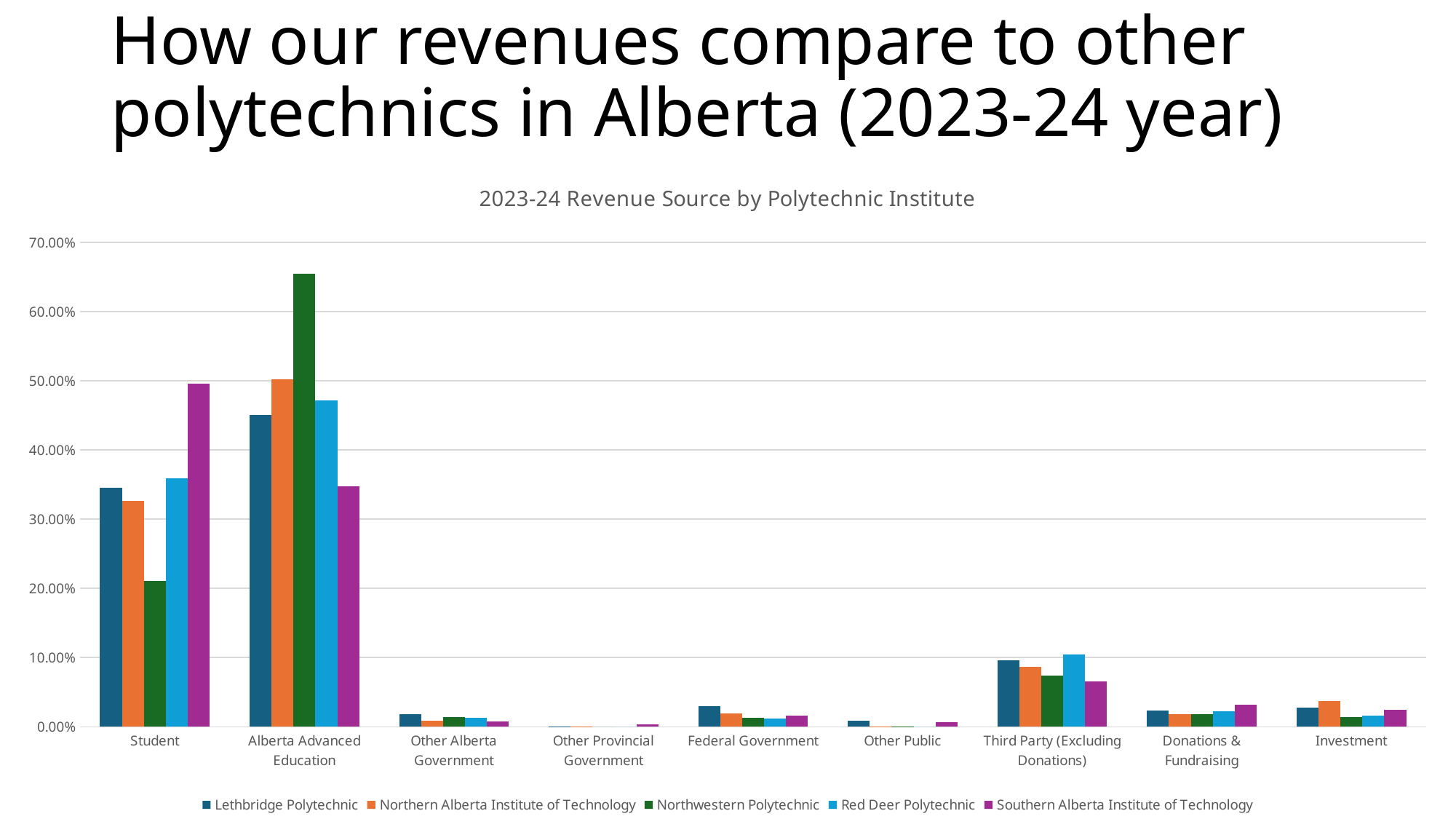
Which institution has the highest share of revenue from Alberta Advanced Education? Northwestern Polytechnic For Alberta Advanced Education, which is larger: Northern Alberta Institute of Technology or Southern Alberta Institute of Technology? Northern Alberta Institute of Technology What is the title of the chart? 2023-24 Revenue Source by Polytechnic Institute Is the Student value for Southern Alberta Institute of Technology greater or less than 40.00%? greater Is the Alberta Advanced Education value for Lethbridge Polytechnic greater or less than 50.00%? less Is the Alberta Advanced Education value for Northwestern Polytechnic greater or less than 60.00%? greater Which institution has the lowest share of revenue from Student? Northwestern Polytechnic What kind of chart is shown on the slide? bar chart For the Student category, which is larger: Lethbridge Polytechnic or Northwestern Polytechnic? Lethbridge Polytechnic How many revenue source categories are shown on the x axis? 9 How many institutions does the legend list? 5 Which institution has the highest share of revenue from Student? Southern Alberta Institute of Technology